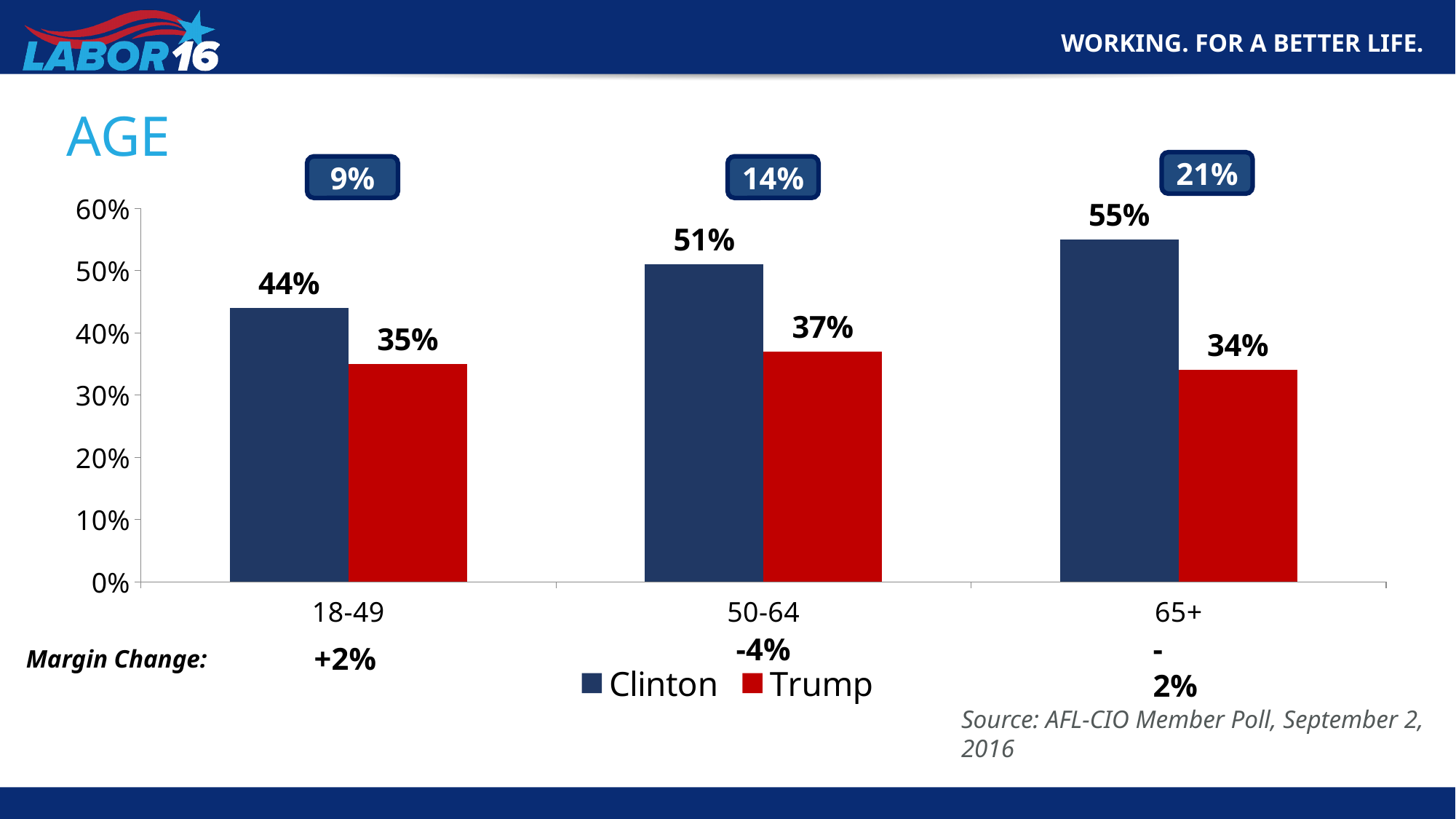
What is the value for Clinton in the 18-49 age group? 44% What is the value for Clinton in the 65+ age group? 55% How many series does the legend list? 2 How many age groups are shown on the x axis? 3 Which age group has the lowest value for Trump? 65+ What is the value for Trump in the 50-64 age group? 37% Do Clinton's values rise or fall across the age groups from 18-49 to 65+? rise What kind of chart is shown on the slide? bar chart What is the difference between Clinton and Trump in the 65+ age group? 21% Is the value for Trump in the 18-49 age group greater or less than 40%? less Which is larger in the 50-64 age group, Clinton or Trump? Clinton Which age group has the highest value for Clinton? 65+